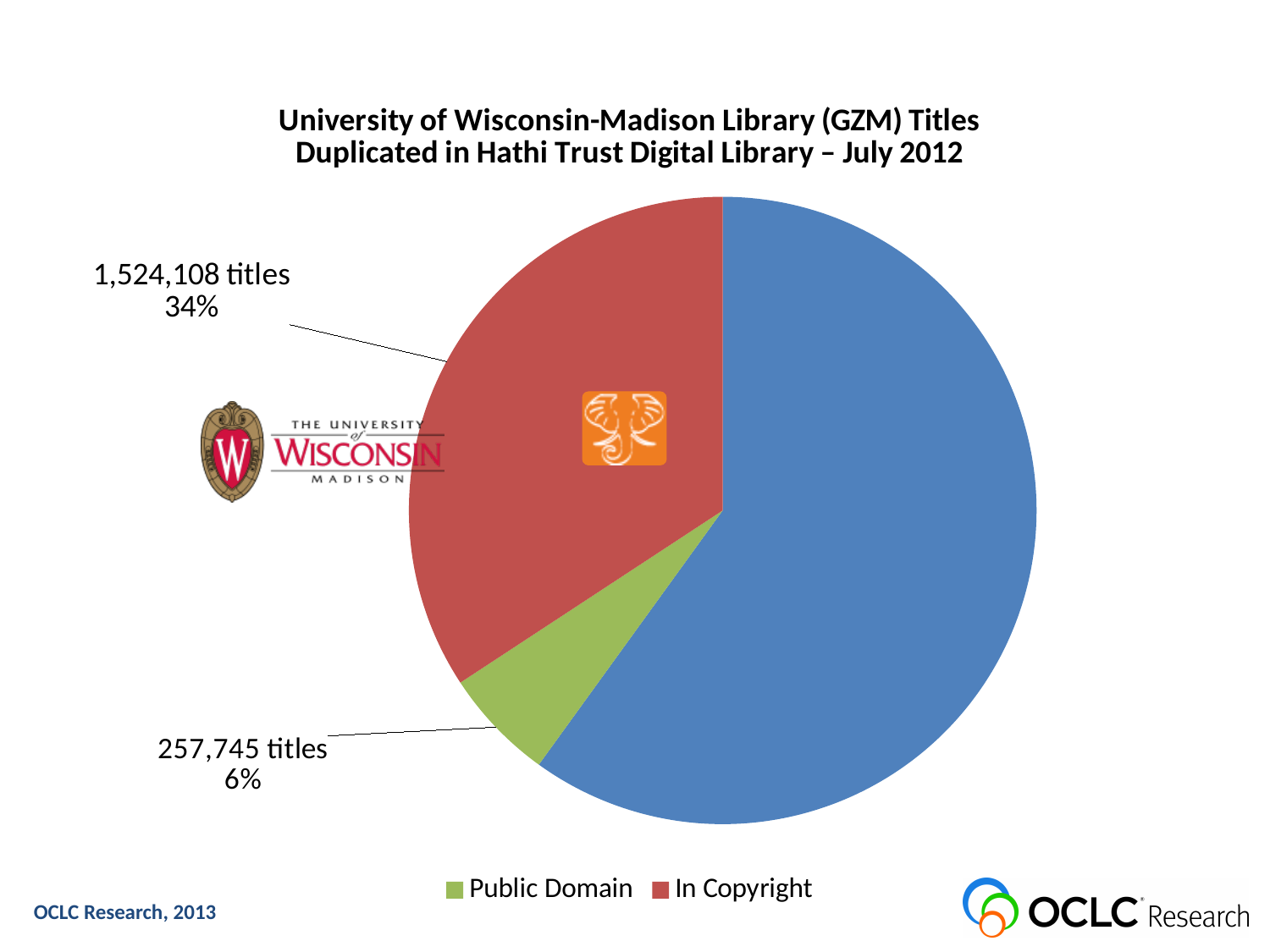
What kind of chart is shown on the slide? Pie chart How many slices does the pie chart have? 3 How many more titles are In Copyright than Public Domain? 1,266,363 titles How many entries does the legend list? 2 How many titles are in the In Copyright slice of the pie chart? 1,524,108 titles What is the combined number of titles in the Public Domain and In Copyright slices? 1,781,853 titles What colour is the Public Domain slice? Green Which slice is larger, Public Domain or In Copyright? In Copyright How many titles are in the Public Domain slice of the pie chart? 257,745 titles By how many percentage points does the In Copyright share exceed the Public Domain share? 28 percentage points What percentage of the pie does the Public Domain slice represent? 6% What percentage of the pie does the In Copyright slice represent? 34%